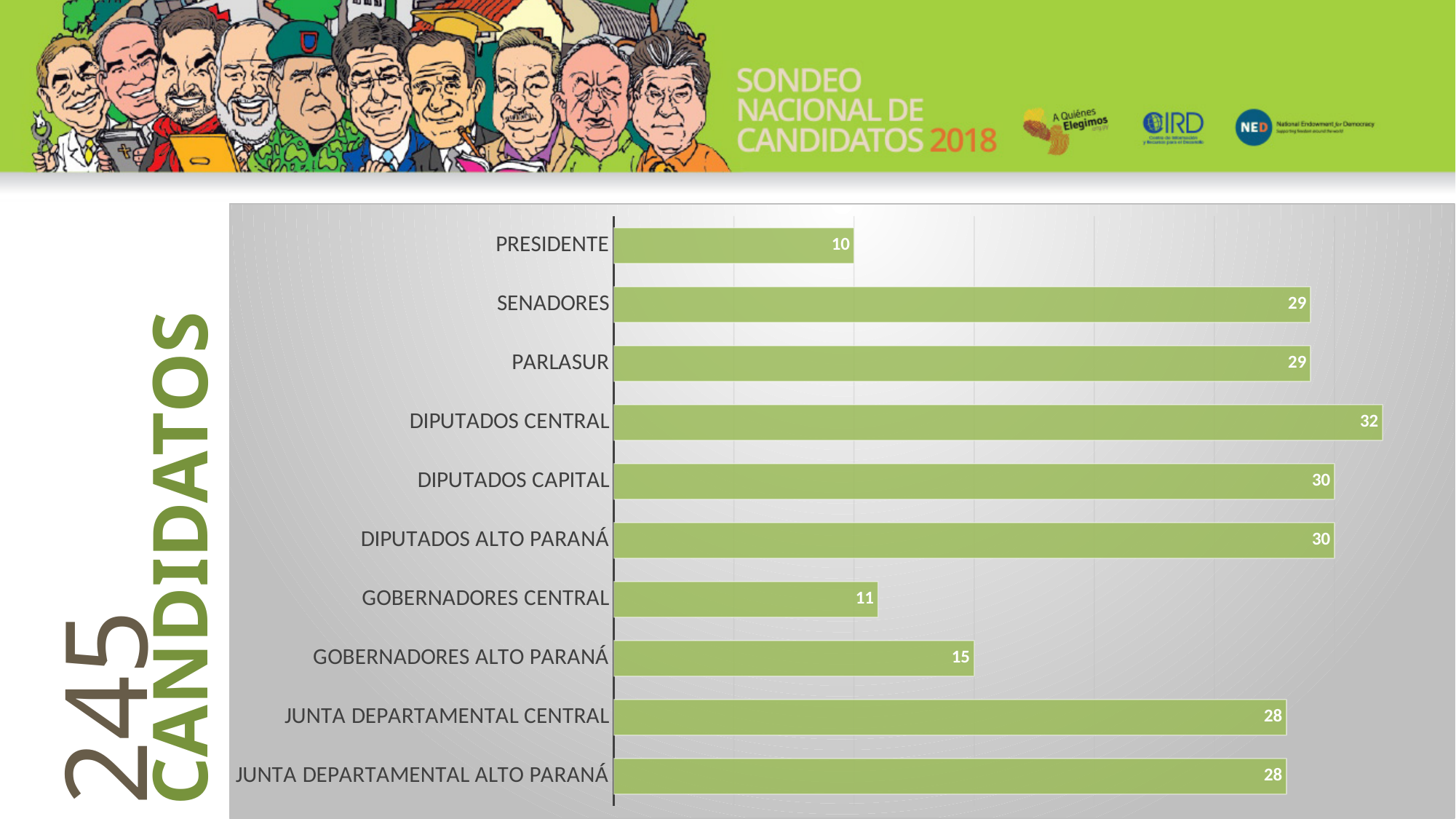
What is the value for JUNTA DEPARTAMENTAL CENTRAL? 28 What total number of candidates is stated in the large text to the left of the chart? 245 CANDIDATOS What is the value for PRESIDENTE? 10 What is the value for GOBERNADORES ALTO PARANÁ? 15 How many categories are shown in the chart? 10 What is the difference between the values for SENADORES and GOBERNADORES CENTRAL? 18 What is the value for DIPUTADOS CENTRAL? 32 What kind of chart is shown on the slide? Bar chart What is the difference between the values for DIPUTADOS CENTRAL and PRESIDENTE? 22 Which category has the lowest value? PRESIDENTE Which is larger, the value for GOBERNADORES ALTO PARANÁ or the value for GOBERNADORES CENTRAL? GOBERNADORES ALTO PARANÁ Which category has the highest value? DIPUTADOS CENTRAL